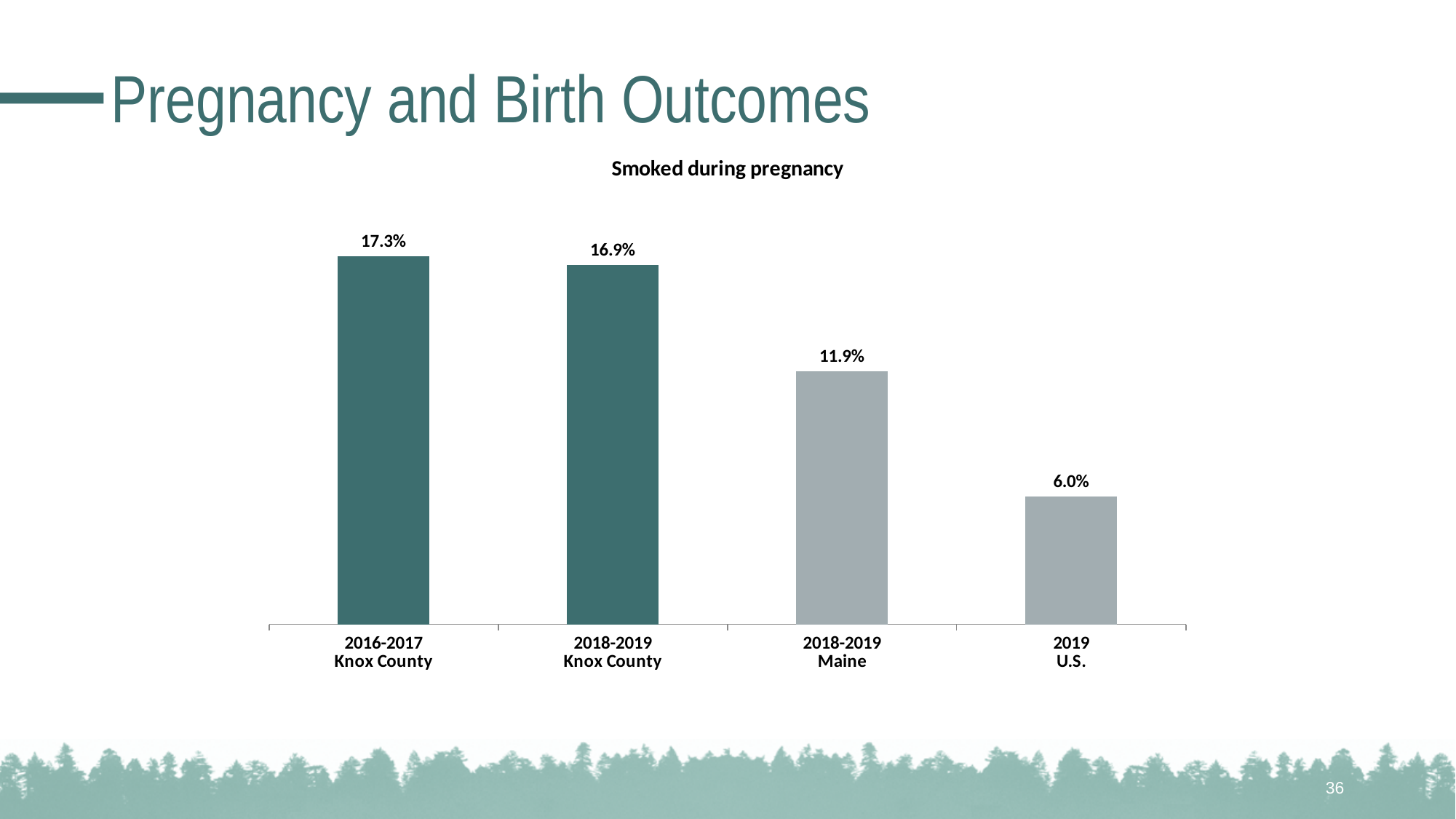
Which category has the lowest value? 2019 U.S. What is the value for 2019 U.S.? 6.0% What is the difference between the 2018-2019 Knox County value and the 2018-2019 Maine value? 5.0% What kind of chart is shown on the slide? Bar chart What is the value for 2018-2019 Maine? 11.9% What is the value for 2016-2017 Knox County in the Smoked during pregnancy chart? 17.3% Which category has the highest value? 2016-2017 Knox County What is the title of the chart? Smoked during pregnancy What is the value for 2018-2019 Knox County? 16.9% Which is larger, the value for 2018-2019 Maine or the value for 2019 U.S.? 2018-2019 Maine What is the difference between the 2016-2017 Knox County value and the 2018-2019 Knox County value? 0.4% How many categories are shown in the chart? 4